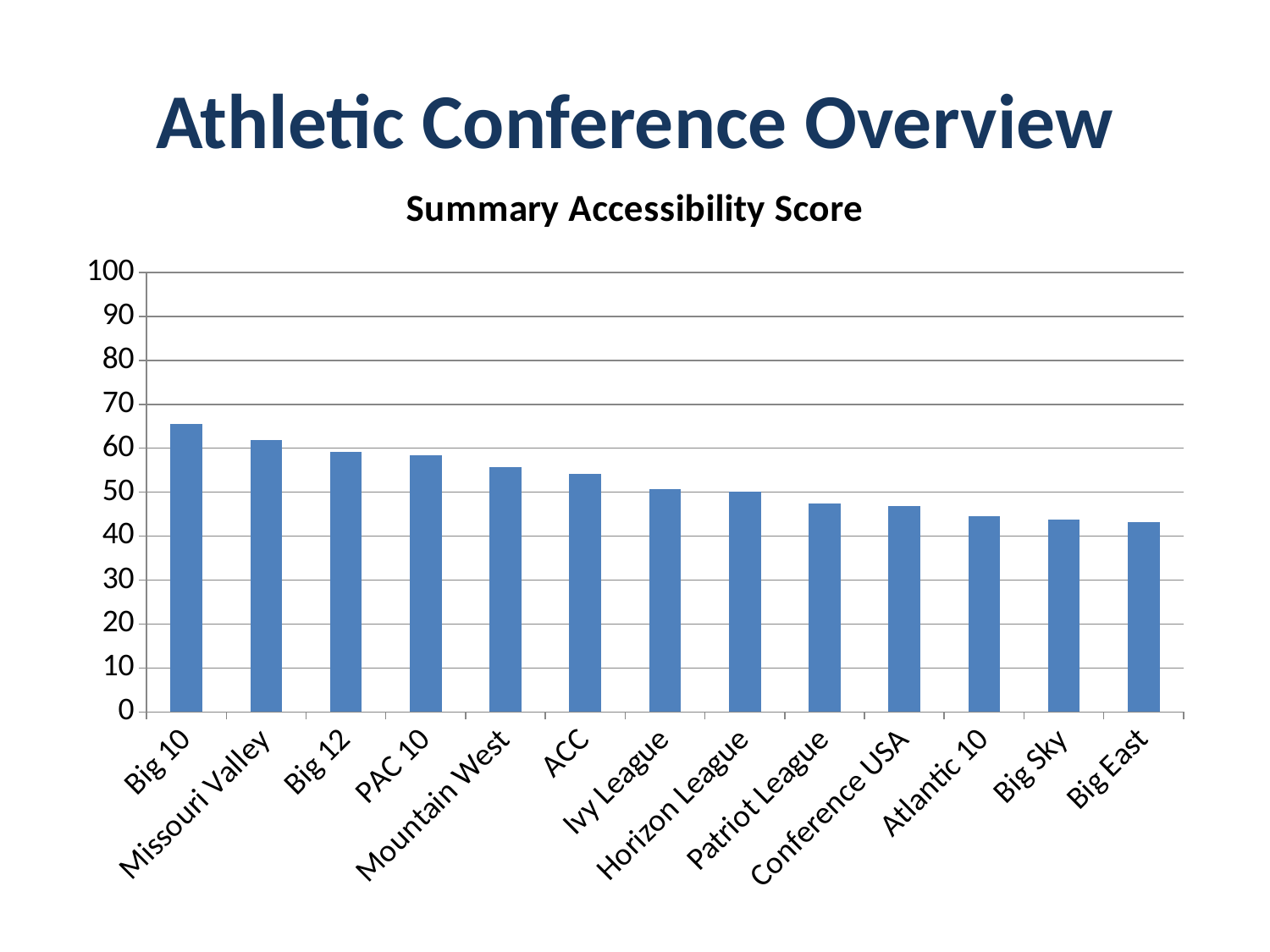
Is the value for Big East greater or less than 50? less Which conference has the highest Summary Accessibility Score? Big 10 Is the value for Big 10 greater or less than 60? greater Which has a larger value, Atlantic 10 or PAC 10? PAC 10 Is the value for Mountain West greater or less than 50? greater What kind of chart is shown on the slide? bar chart Which conference has the lowest Summary Accessibility Score? Big East Do the values rise or fall moving from left to right along the x axis? fall Which has a larger value, Missouri Valley or ACC? Missouri Valley What is the title of the chart? Summary Accessibility Score How many athletic conferences are plotted in the chart? 13